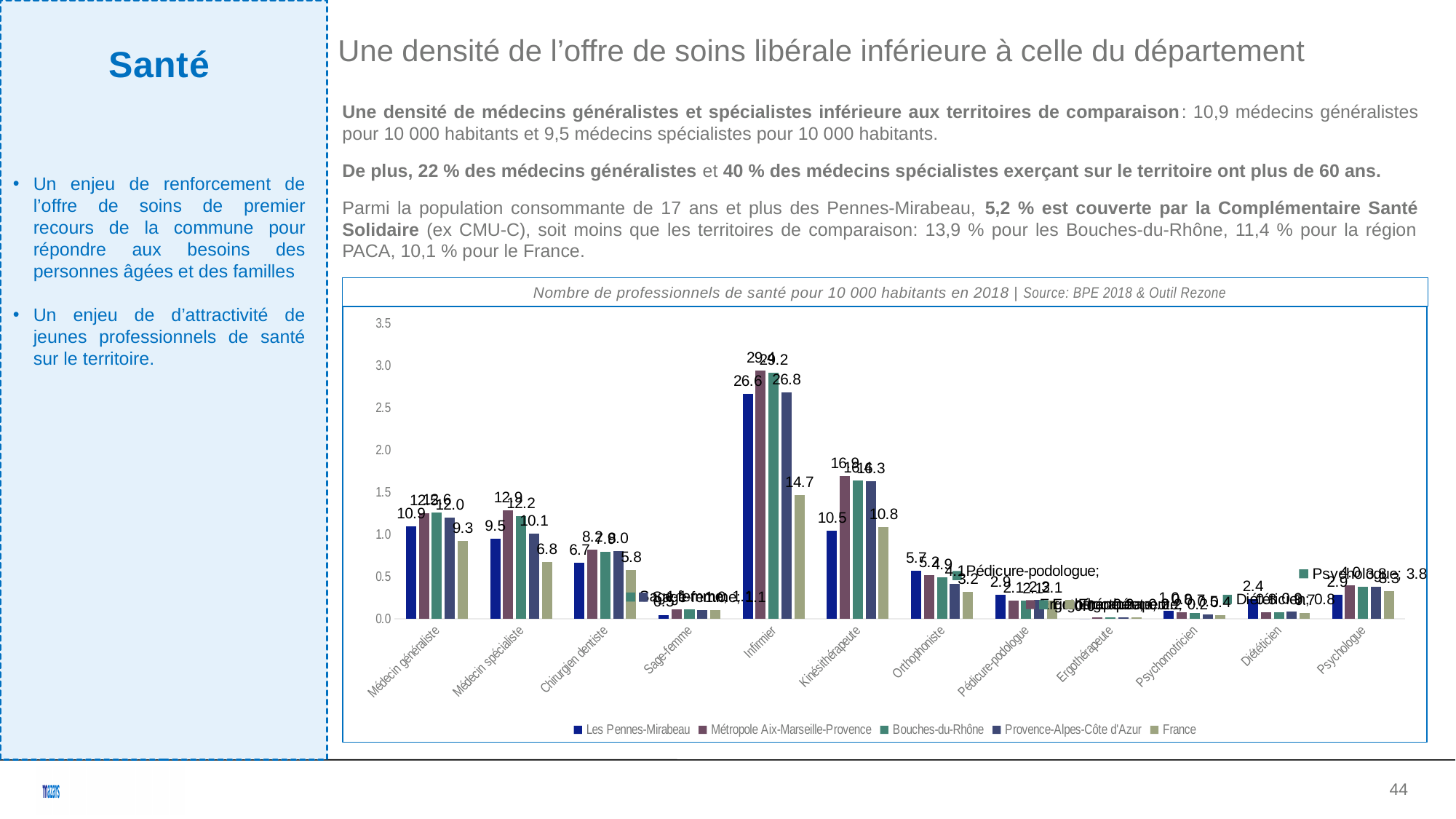
What is the value for Les Pennes-Mirabeau in the Médecin généraliste category? 10.9 What type of chart is shown on the slide? bar chart How many categories of health professionals are shown on the x axis of the chart? 12 What is the title of the chart? Nombre de professionnels de santé pour 10 000 habitants en 2018 What is the value for Les Pennes-Mirabeau in the Infirmier category? 26.6 What is the difference between the Métropole Aix-Marseille-Provence value (12.9) and the Les Pennes-Mirabeau value (9.5) for Médecin spécialiste? 3.4 What is the value for France in the Kinésithérapeute category? 10.8 How many series does the legend of the chart list? 5 For Infirmier, which is larger: the value for Les Pennes-Mirabeau or the value for France? Les Pennes-Mirabeau Which category has the highest values across all series in the chart? Infirmier For Orthophoniste, which is larger: the value for Les Pennes-Mirabeau (5.7) or the value for France (3.2)? Les Pennes-Mirabeau What is the value for France in the Médecin spécialiste category? 6.8